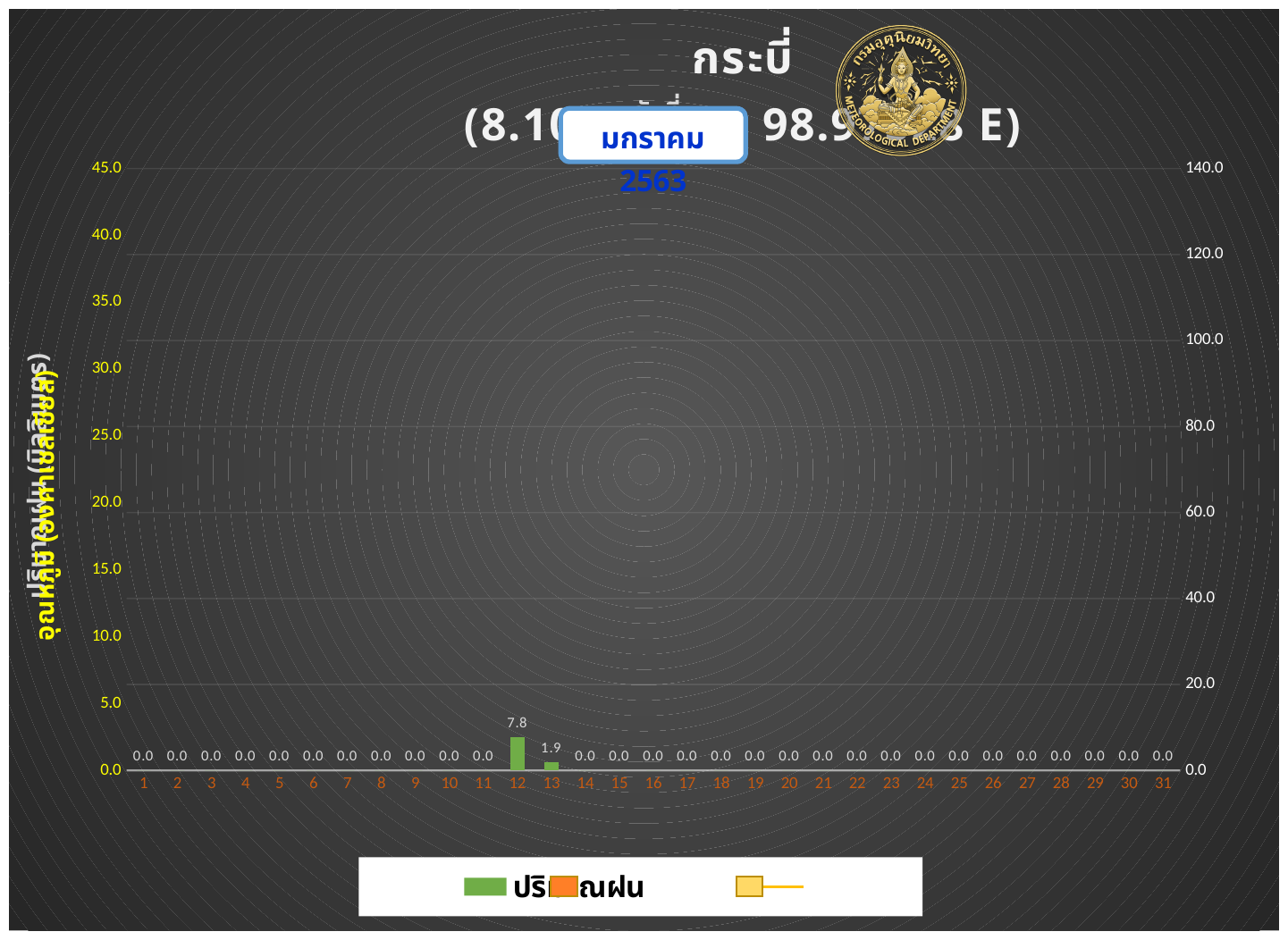
Which is larger, the value for day 12 or the value for day 13? day 12 What is the difference between the values for day 12 and day 13? 5.9 Is the value for day 12 greater or less than 10.0? less What is the value shown for day 13? 1.9 What is the value shown for day 12? 7.8 What is the value shown for day 1? 0.0 What is the value shown for day 31? 0.0 What kind of chart is this? bar chart Which day has the highest value? 12 How many days are shown on the x axis? 31 What is the highest tick value on the left y axis? 45.0 What is the highest tick value on the right y axis? 140.0